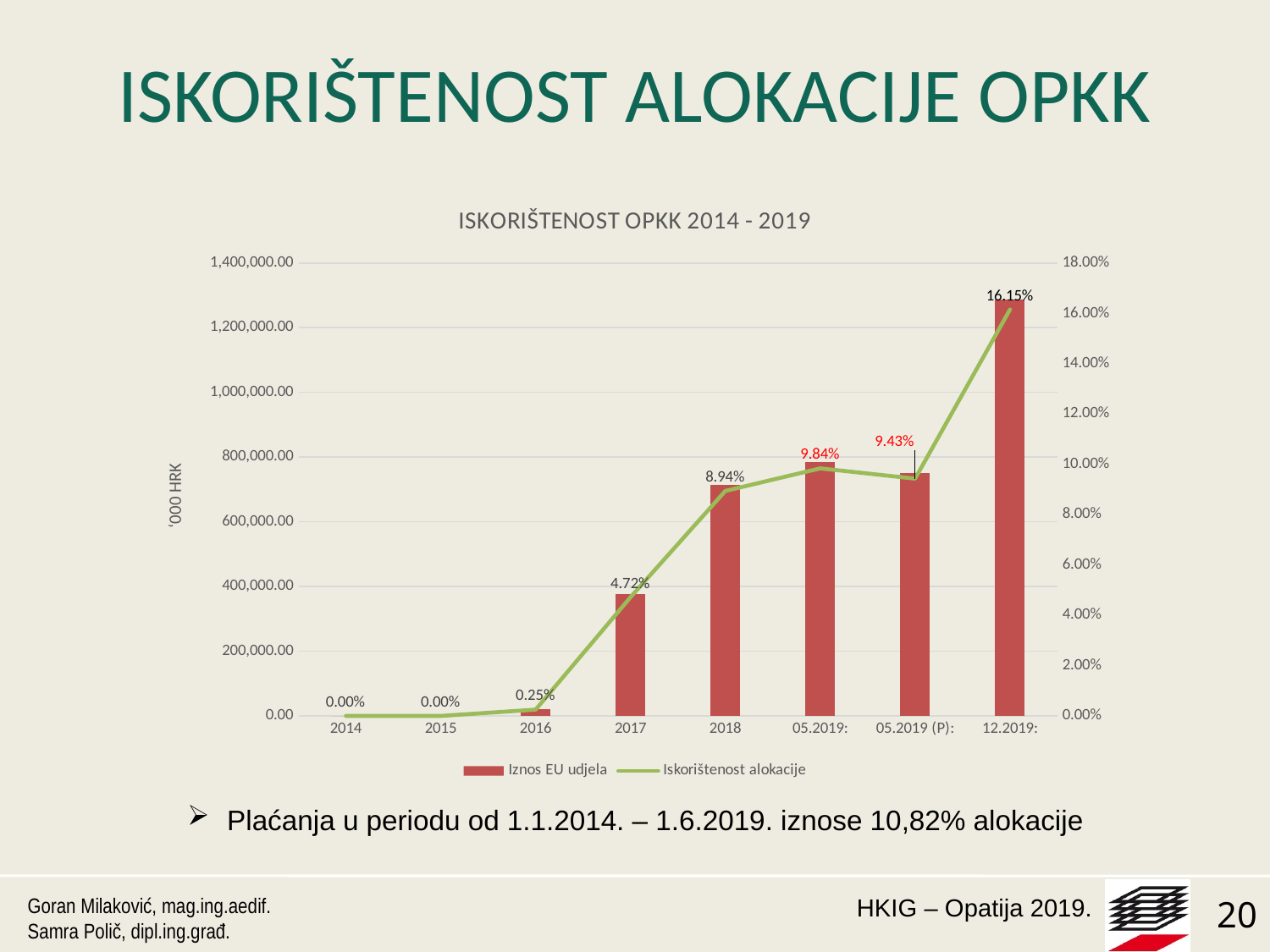
What is the title of the chart? ISKORIŠTENOST OPKK 2014 - 2019 Is the Iznos EU udjela bar for 2017 greater or less than 400,000.00? less What is the Iskorištenost alokacije value for 12.2019:? 16.15% How many categories are shown on the x axis? 8 Which is larger, the Iskorištenost alokacije value for 05.2019: or for 05.2019 (P):? 05.2019: What is the difference between the Iskorištenost alokacije values for 2018 and 2017? 4.22% How many series does the legend list? 2 Is the Iznos EU udjela bar for 12.2019: greater or less than 1,200,000.00? greater Which category has the highest Iskorištenost alokacije value? 12.2019: What is the Iskorištenost alokacije value for 2017? 4.72% What kind of chart is shown on the slide? Combined bar and line chart What is the Iskorištenost alokacije value for 05.2019 (P):? 9.43%